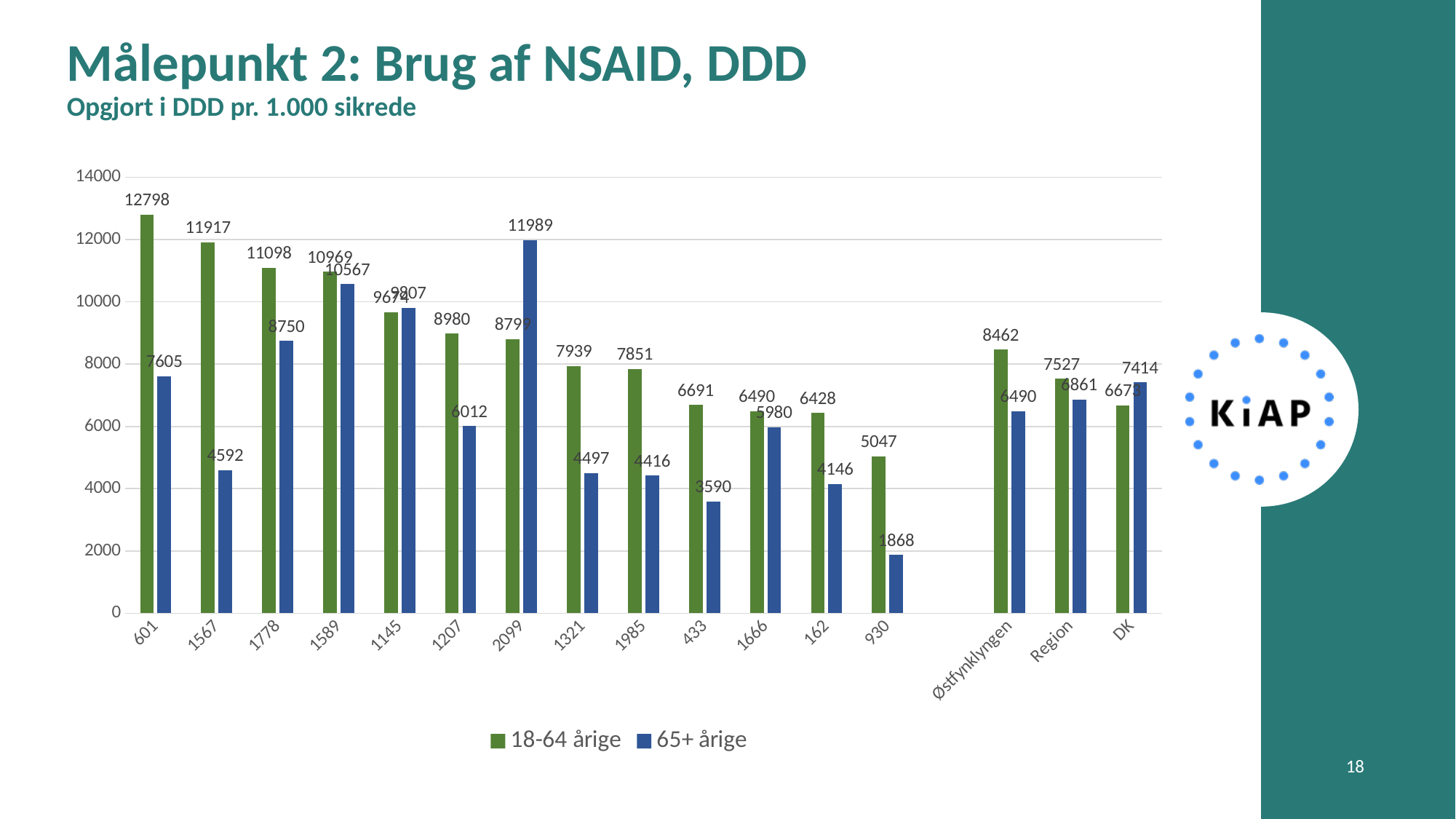
For category 2099, which series has the larger value, 18-64 årige or 65+ årige? 65+ årige How many series does the legend list? 2 What is the value for 18-64 årige for category 601? 12798 How many categories are shown on the x axis? 16 Is the value for 65+ årige for category 1589 greater or less than 10000? greater Which category has the highest value for 18-64 årige? 601 What is the value for 65+ årige for Region? 6861 What is the difference between the 18-64 årige and 65+ årige values for Østfynklyngen? 1972 Which category has the lowest value for 65+ årige? 930 What is the difference between the 18-64 årige and 65+ årige values for category 930? 3179 What kind of chart is shown on the slide? bar chart What is the value for 65+ årige for category 2099? 11989